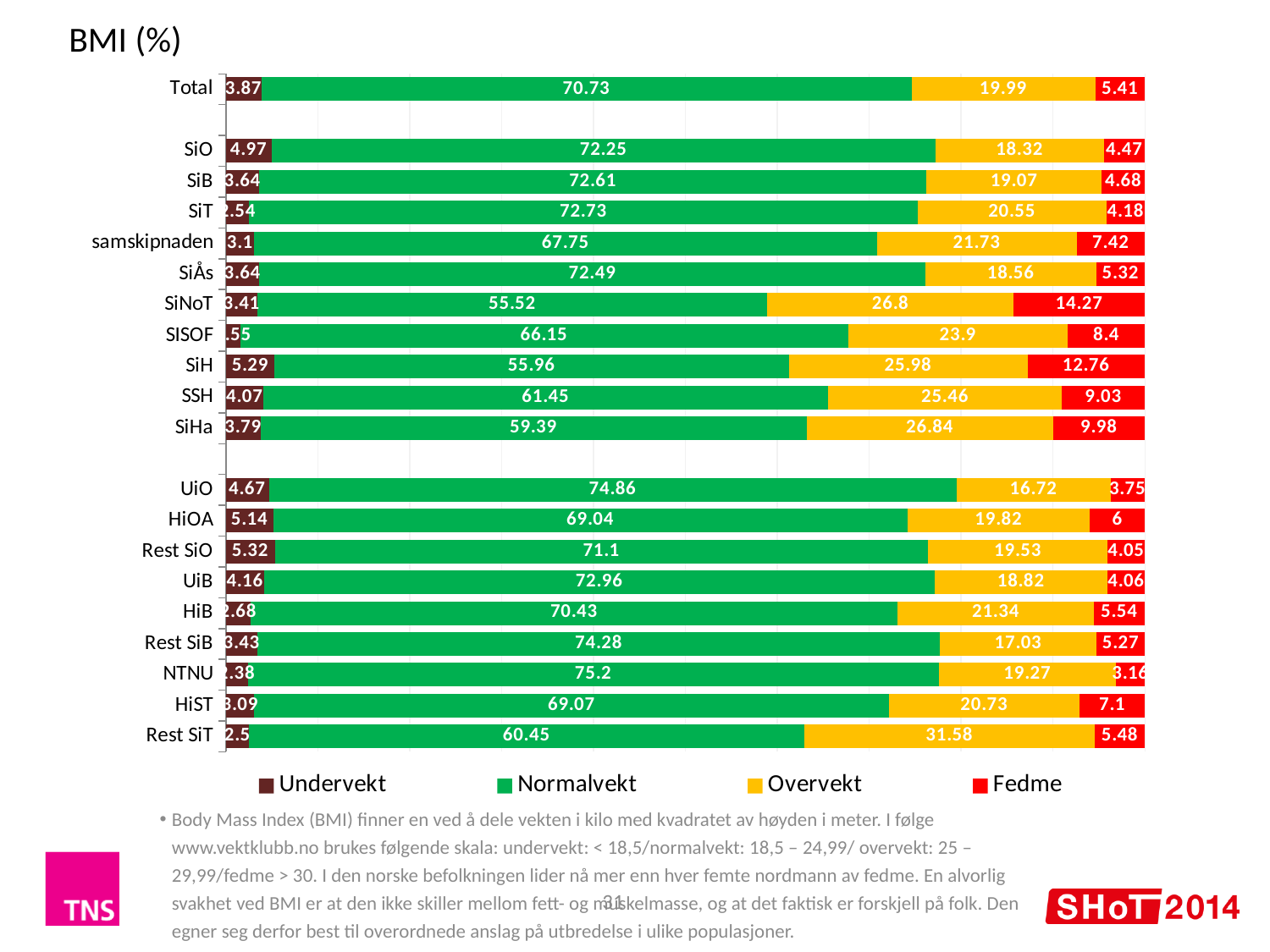
What is the Normalvekt value for Total? 70.73 Which category has the lowest Normalvekt value? SiNoT What is the Fedme value for SiNoT? 14.27 What kind of chart is shown on the slide? Stacked bar chart Which category has the highest Normalvekt value? NTNU How many categories are shown on the y axis? 20 What is the Overvekt value for Rest SiT? 31.58 Which category has the highest Fedme value? SiNoT How many series does the legend list? 4 What is the Undervekt value for HiOA? 5.14 Which has the larger Normalvekt value, UiO or HiOA? UiO What is the difference between the Fedme values for SiNoT and SiH? 1.51